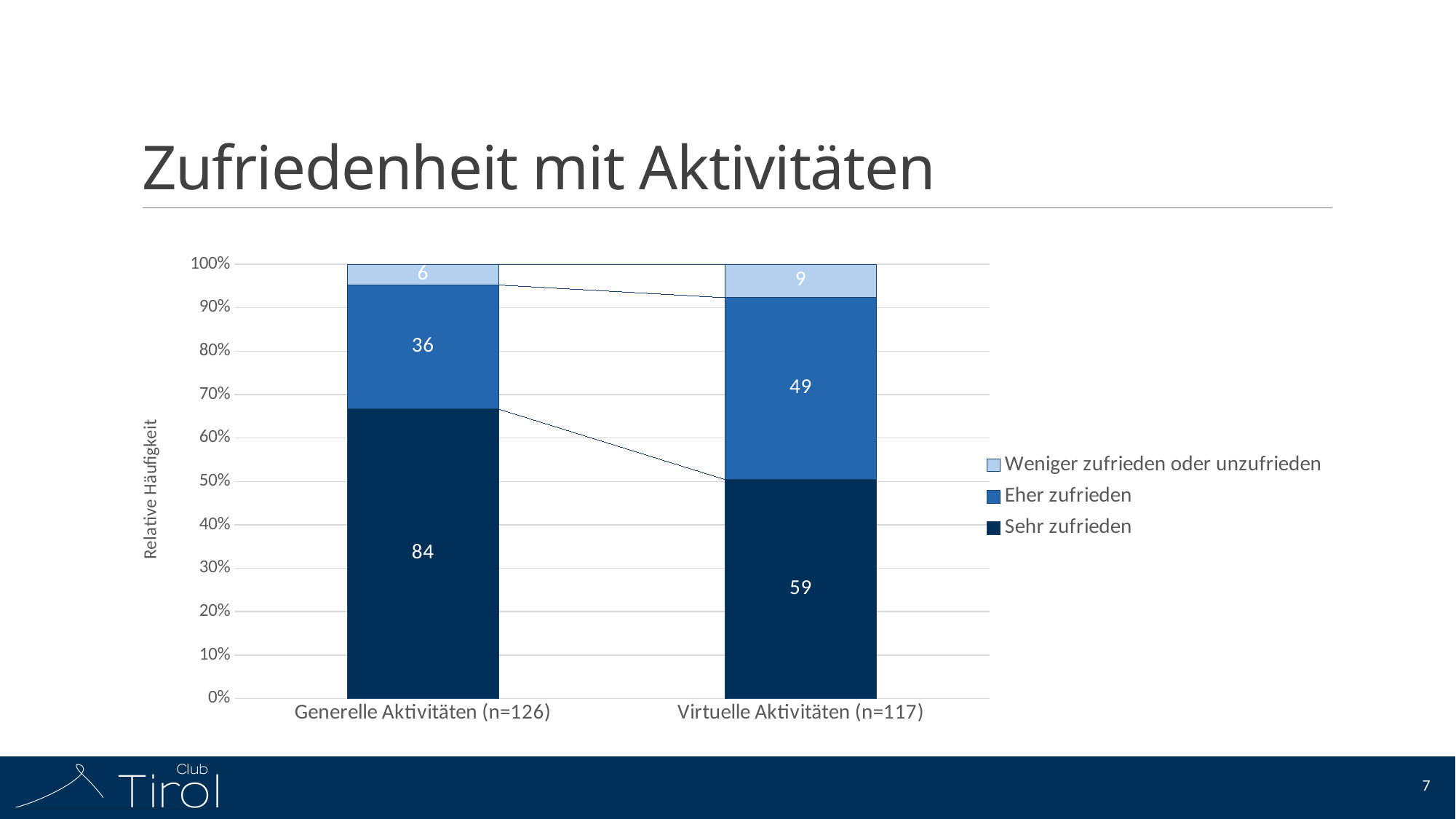
What is the total of the data labels in the "Virtuelle Aktivitäten (n=117)" bar? 117 What is the data label for "Sehr zufrieden" in the "Generelle Aktivitäten (n=126)" bar? 84 Which series has the largest data label in the "Generelle Aktivitäten (n=126)" bar? Sehr zufrieden Is the share of "Sehr zufrieden" in the "Generelle Aktivitäten (n=126)" bar greater or less than 60%? greater What kind of chart is shown on the slide? Stacked bar chart Which category has the larger "Eher zufrieden" data label, "Generelle Aktivitäten (n=126)" or "Virtuelle Aktivitäten (n=117)"? Virtuelle Aktivitäten (n=117) Which series has the smallest data label in the "Virtuelle Aktivitäten (n=117)" bar? Weniger zufrieden oder unzufrieden What is the data label for "Weniger zufrieden oder unzufrieden" in the "Virtuelle Aktivitäten (n=117)" bar? 9 What is the data label for "Eher zufrieden" in the "Virtuelle Aktivitäten (n=117)" bar? 49 How many categories are shown on the x axis? 2 What is the difference between the "Sehr zufrieden" data labels for "Generelle Aktivitäten (n=126)" and "Virtuelle Aktivitäten (n=117)"? 25 How many series does the legend list? 3